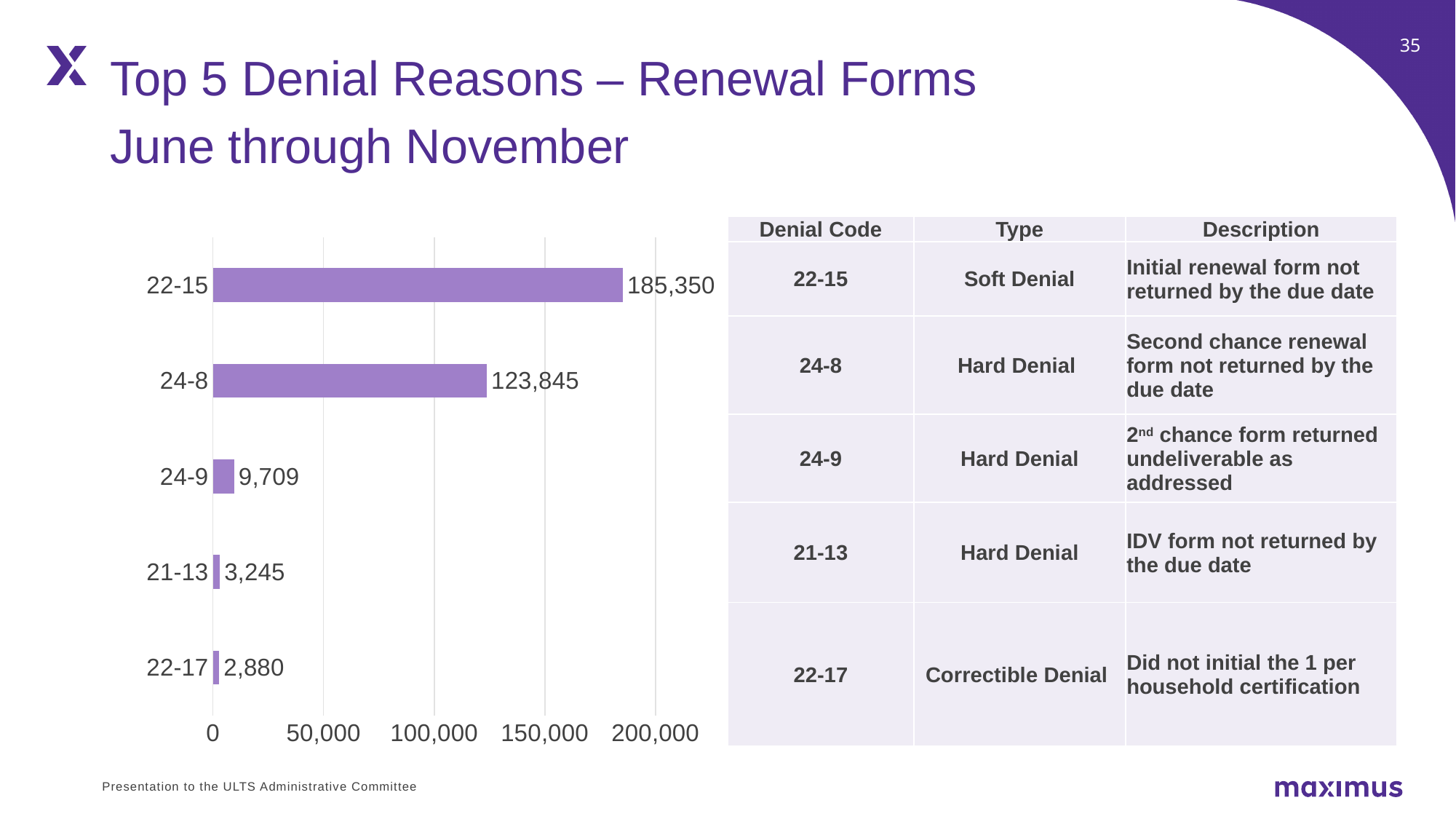
What is the value for denial code 22-15? 185,350 Which is larger, the value for 24-9 or the value for 21-13? 24-9 How many denial codes are shown in the chart? 5 What is the value for denial code 22-17? 2,880 What kind of chart is shown on the slide? bar chart What is the value for denial code 24-8? 123,845 Is the value for 24-8 greater or less than 100,000? greater What is the value for denial code 24-9? 9,709 Which denial code has the highest value? 22-15 Which denial code has the lowest value? 22-17 What is the difference between the values for 22-15 and 24-8? 61,505 What is the difference between the values for 21-13 and 22-17? 365